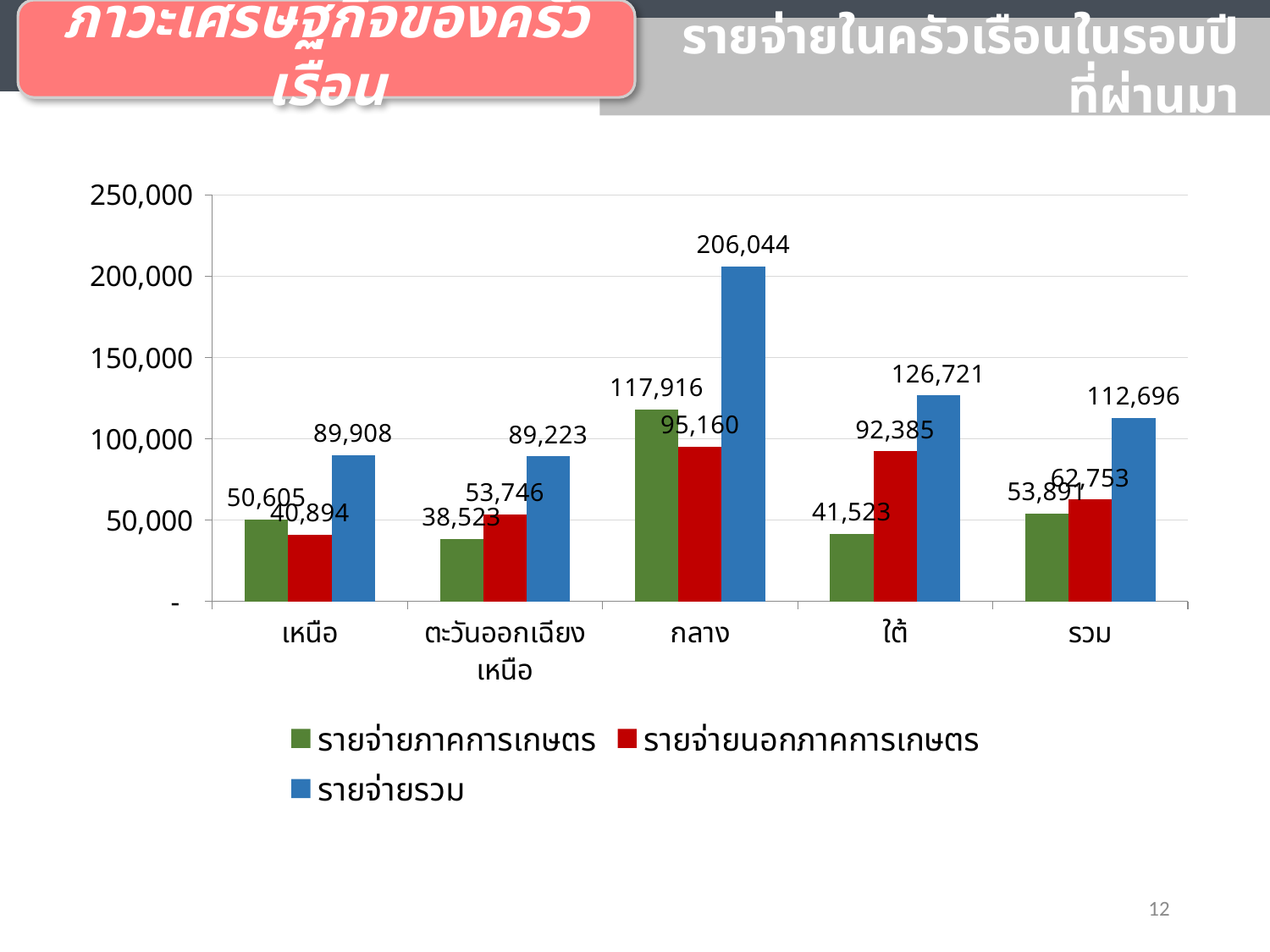
What type of chart is shown on the slide? bar chart Is the value of รายจ่ายรวม for รวม greater or less than 100,000? greater Which is larger for เหนือ: รายจ่ายภาคการเกษตร or รายจ่ายนอกภาคการเกษตร? รายจ่ายภาคการเกษตร Which category has the highest value for รายจ่ายรวม? กลาง What is the value of รายจ่ายรวม for กลาง? 206,044 What is the value of รายจ่ายนอกภาคการเกษตร for ใต้? 92,385 What is the value of รายจ่ายภาคการเกษตร for ตะวันออกเฉียงเหนือ? 38,523 What is the difference between รายจ่ายรวม for กลาง and รายจ่ายรวม for ใต้? 79,323 Which category has the lowest value for รายจ่ายภาคการเกษตร? ตะวันออกเฉียงเหนือ How many categories are shown on the x axis? 5 Which colour represents รายจ่ายรวม in the chart? blue How many series does the legend list? 3